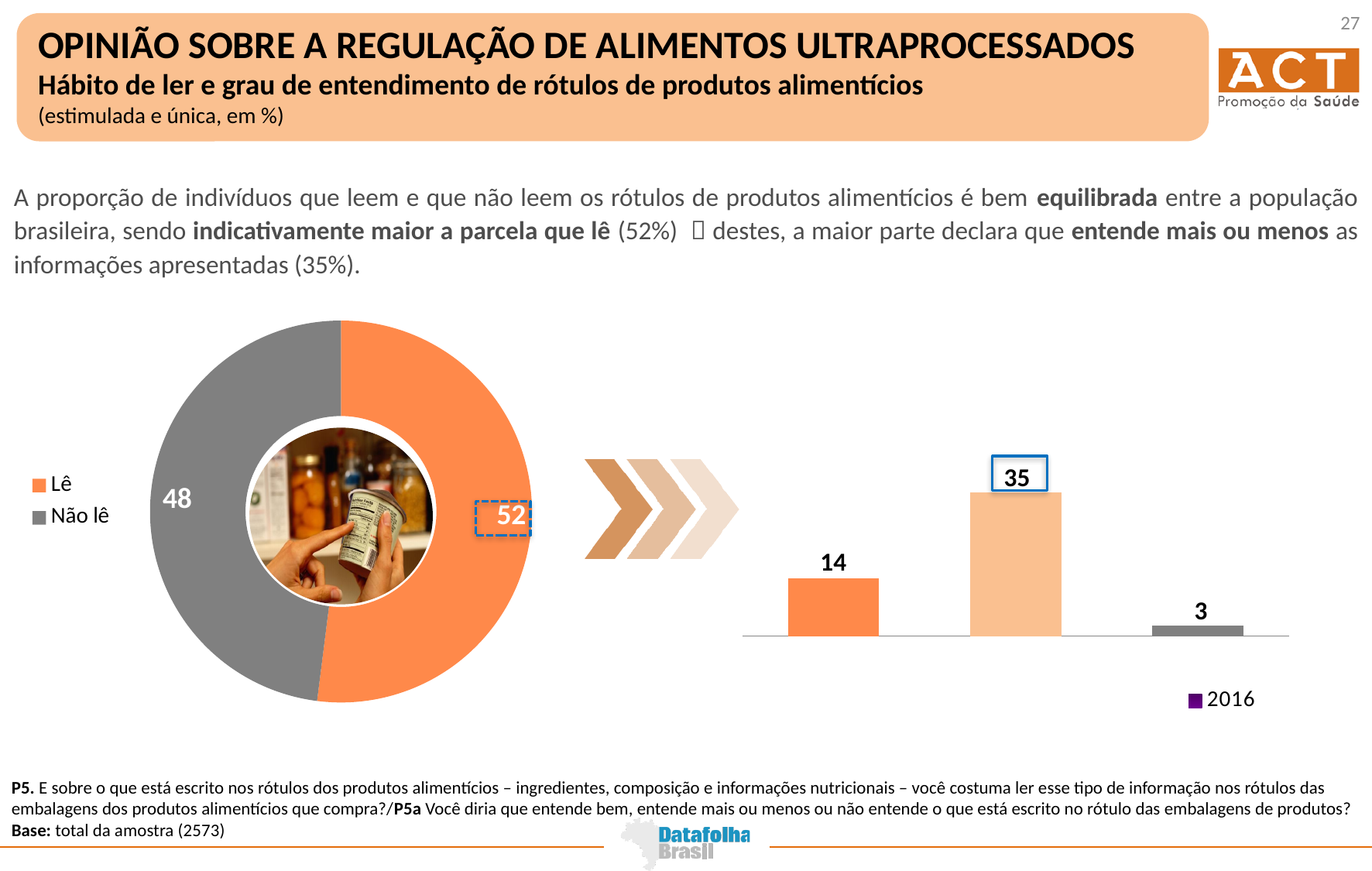
In the bar chart on the right, what is the difference between the middle bar (35) and the left bar (14)? 21 How many bars are plotted in the bar chart on the right? 3 How many categories does the legend of the pie chart on the left list? 2 In the pie chart on the left, which category has the larger share, "Lê" or "Não lê"? Lê What kind of chart is the chart on the left of the slide? Doughnut chart What series does the legend of the bar chart on the right list? 2016 In the pie chart on the left, what is the difference between the values for "Lê" and "Não lê"? 4 In the bar chart on the right, what is the highest value shown? 35 What kind of chart is the chart on the right of the slide? Bar chart In the bar chart on the right, what is the lowest value shown? 3 In the pie chart on the left, what is the value for "Não lê"? 48 In the pie chart on the left, what is the value for "Lê"? 52